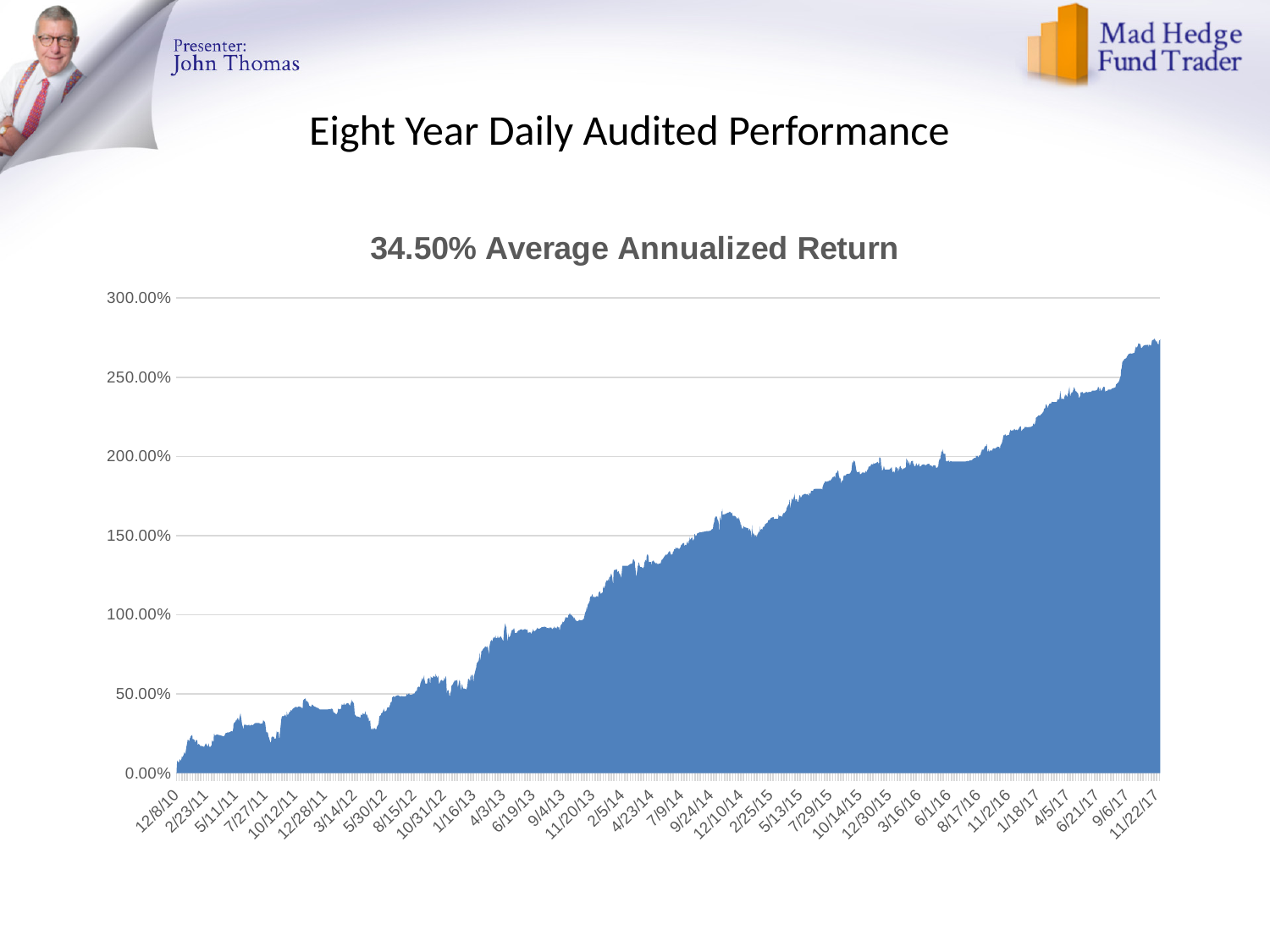
What is the highest tick label shown on the y axis? 300.00% Is the value at 1/16/13 greater or less than 50.00%? greater What is the title shown above the chart? 34.50% Average Annualized Return What is the first date label on the x axis? 12/8/10 Is the value at 12/8/10 greater or less than 50.00%? less Is the value at 11/2/16 greater or less than 200.00%? greater Do the plotted values generally rise or fall from left to right along the x axis? rise What kind of chart is shown on the slide? area chart Which is larger, the value at 11/22/17 or the value at 12/8/10? 11/22/17